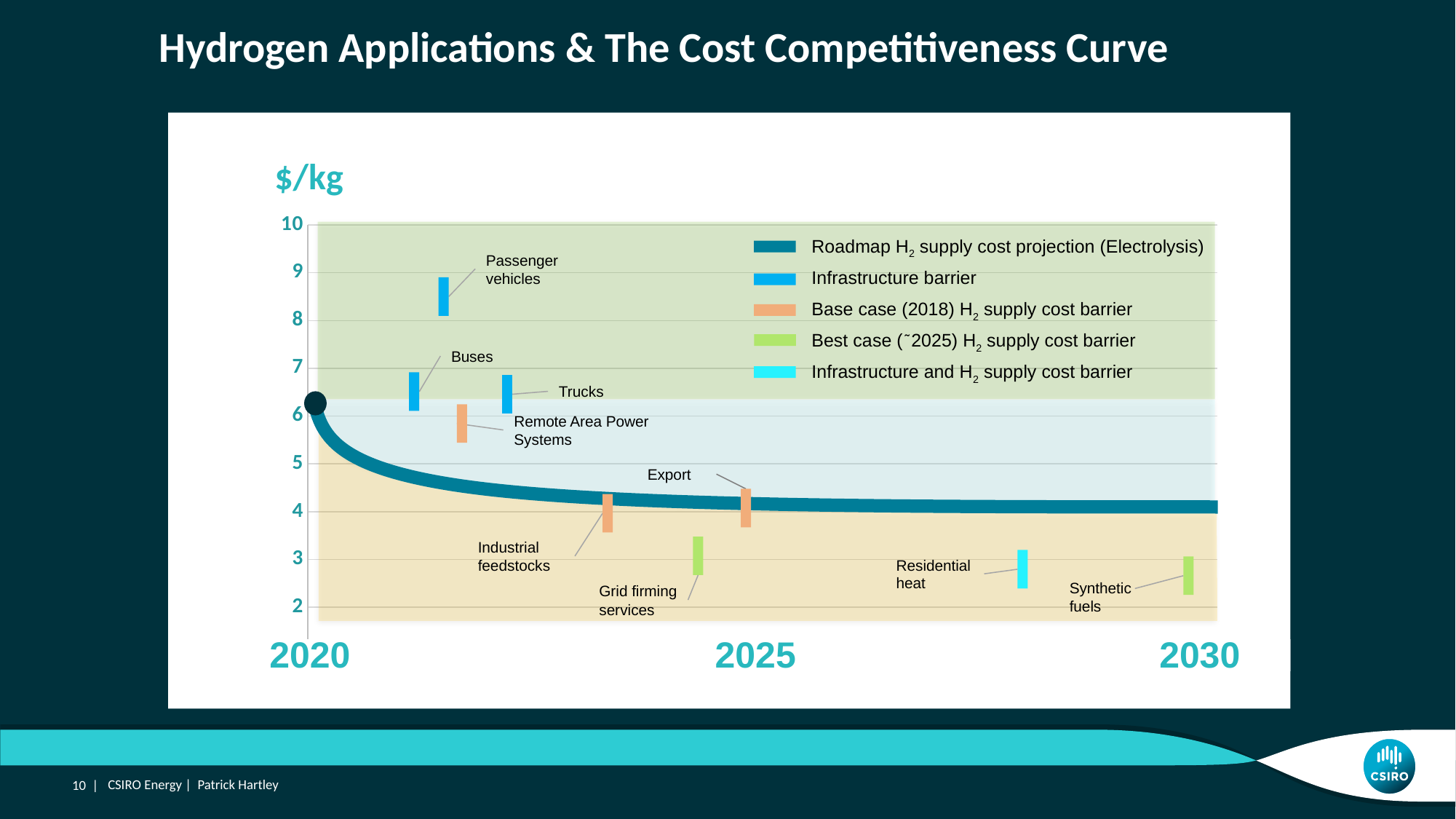
How many entries does the chart legend list? 5 Is the cost barrier marker for Grid firming services greater or less than 4 $/kg? less Is the cost barrier marker for Passenger vehicles greater or less than 8 $/kg? greater Which labelled hydrogen application has the highest cost barrier marker on the chart? Passenger vehicles Is the cost barrier marker for Synthetic fuels greater or less than 4 $/kg? less What kind of chart is shown on the slide? line chart Which years are labelled on the horizontal axis of the chart? 2020, 2025, 2030 Which has a higher cost barrier marker on the chart, Passenger vehicles or Synthetic fuels? Passenger vehicles What unit is shown on the vertical axis of the chart? $/kg Does the Roadmap H2 supply cost projection (Electrolysis) curve rise or fall from 2020 to 2030? fall